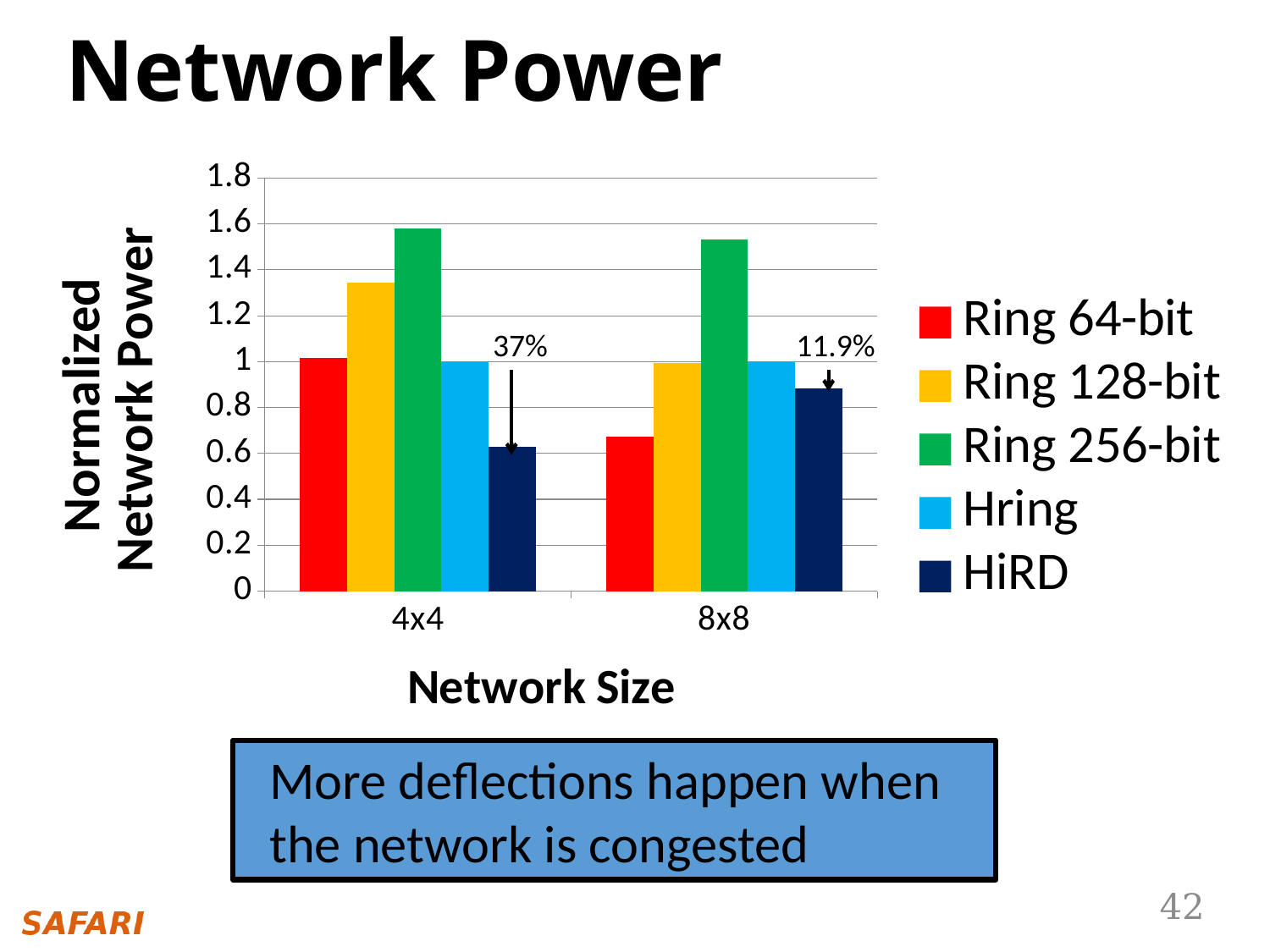
Which is larger for HiRD: the value at 4x4 or the value at 8x8? 8x8 Which series has the lowest normalized network power for the 4x4 network size? HiRD Which series has the highest normalized network power for the 4x4 network size? Ring 256-bit What kind of chart is shown on the slide? bar chart Which is larger at 4x4: the value for Ring 128-bit or the value for Ring 64-bit? Ring 128-bit How many network size categories are shown on the x axis? 2 What percentage annotation is shown above the HiRD bar for the 4x4 network size? 37% How many series does the legend list? 5 Which series has the lowest normalized network power for the 8x8 network size? Ring 64-bit Is the value for Ring 64-bit at 8x8 greater or less than 0.8? less Is the value for Ring 256-bit at 4x4 greater or less than 1.4? greater Is the value for HiRD at 4x4 greater or less than 0.8? less